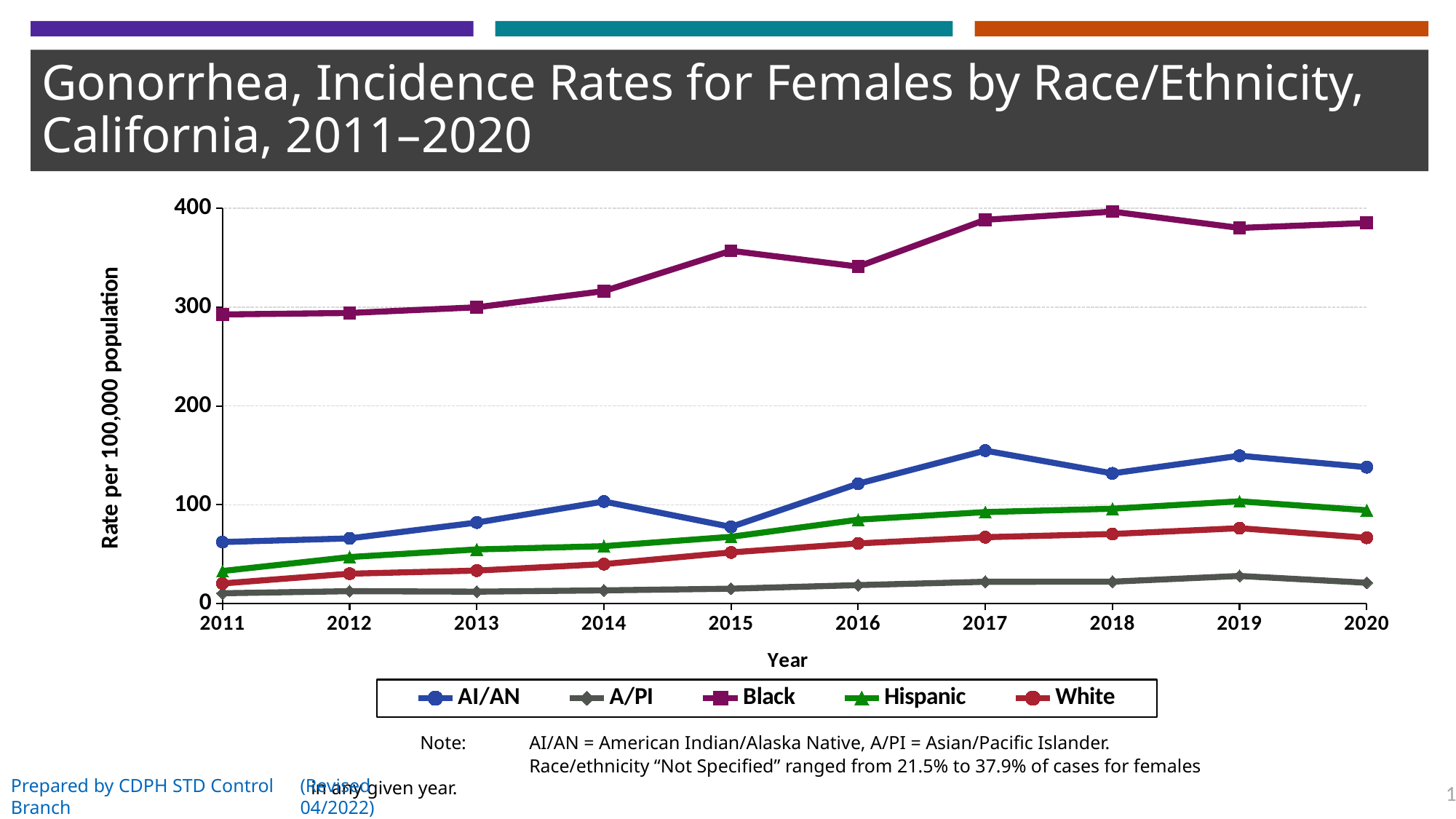
Is the rate for AI/AN females in 2017 greater or less than 200? less What kind of chart is shown on the slide? line chart Does the rate for Black females generally rise or fall from 2011 to 2020? rise Which race/ethnicity group has the lowest gonorrhea incidence rate for females in 2015? A/PI In 2016, which is larger: the rate for AI/AN females or the rate for Hispanic females? AI/AN Which race/ethnicity group has the highest gonorrhea incidence rate for females in 2020? Black How many years are plotted along the x axis? 10 Is the rate for White females in 2011 greater or less than 100? less What is the label on the y axis of the chart? Rate per 100,000 population How many series does the legend list? 5 Is the rate for Black females in 2018 greater or less than 300? greater